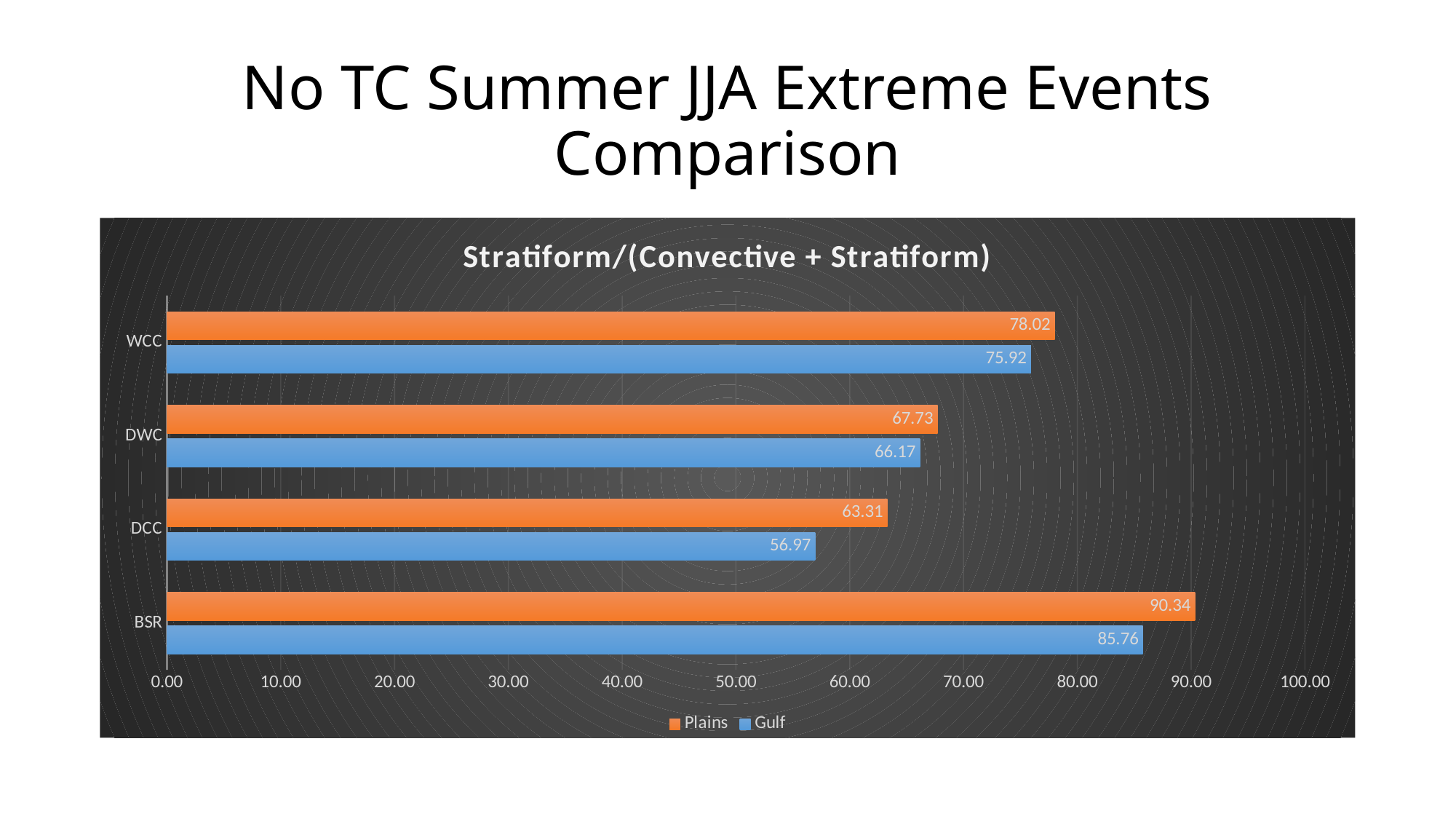
What is the Gulf value for BSR? 85.76 What is the difference between the Plains and Gulf values for DCC? 6.34 What kind of chart is shown on the slide? Bar chart What is the Plains value for WCC? 78.02 Which category has the highest Plains value? BSR Which category has the lowest Gulf value? DCC How many series does the legend list? 2 Which is larger for DWC, the Plains value or the Gulf value? Plains What is the Gulf value for DCC? 56.97 Is the Gulf value for WCC greater or less than 70.00? greater What is the difference between the Plains values for BSR and WCC? 12.32 How many categories are shown on the chart? 4